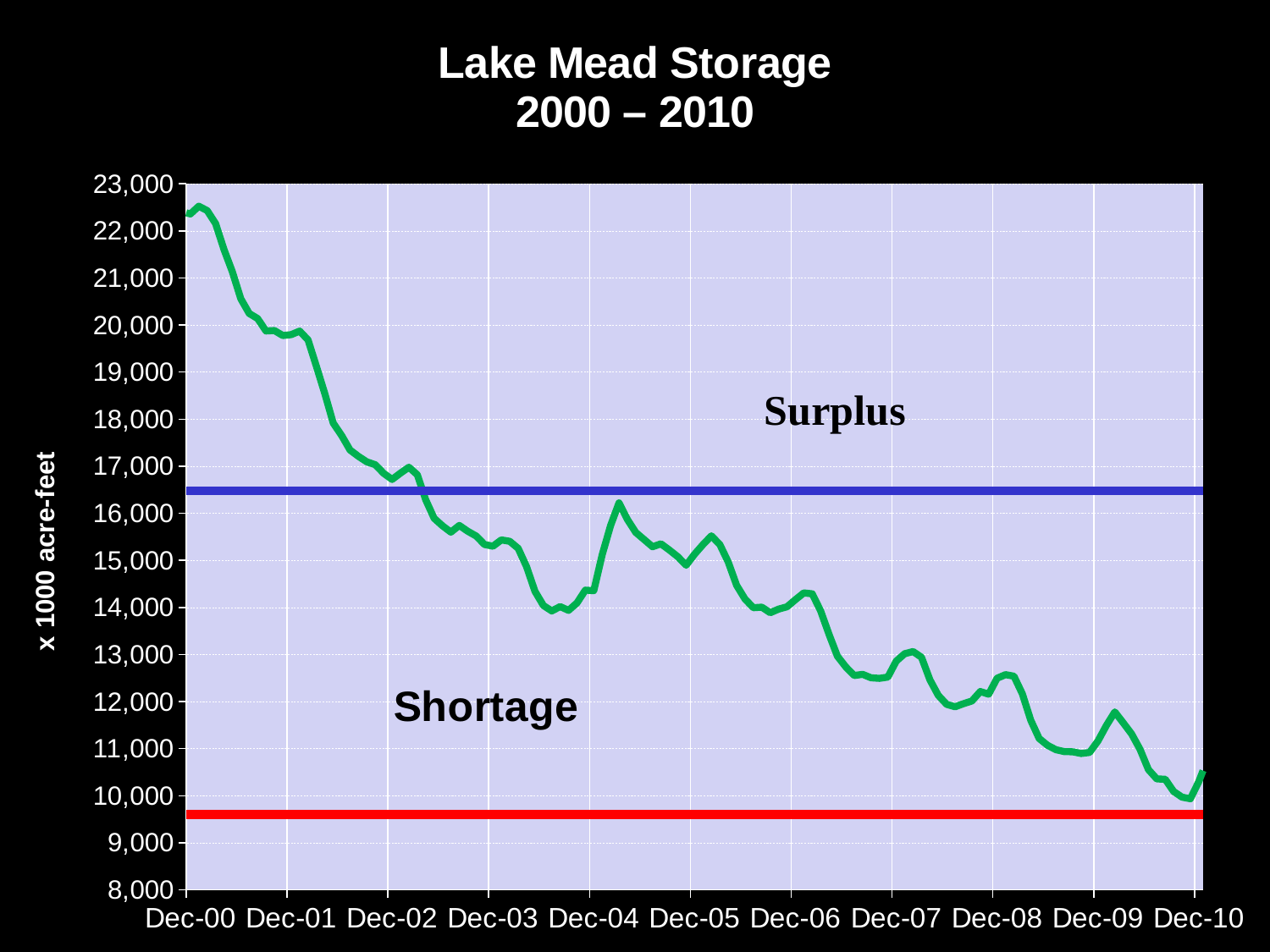
Is the storage value at Dec-00 greater or less than 21,000? greater Is the blue horizontal line greater or less than 16,000? greater Which is larger, the storage value at Dec-00 or at Dec-10? Dec-00 Is the storage value at Dec-04 greater or less than 15,000? less What is the label on the vertical axis? x 1000 acre-feet What is the title of the chart? Lake Mead Storage 2000 – 2010 Does the green storage line generally rise or fall from Dec-00 to Dec-10? fall What kind of chart is shown on the slide? line chart How many date labels are shown along the x axis? 11